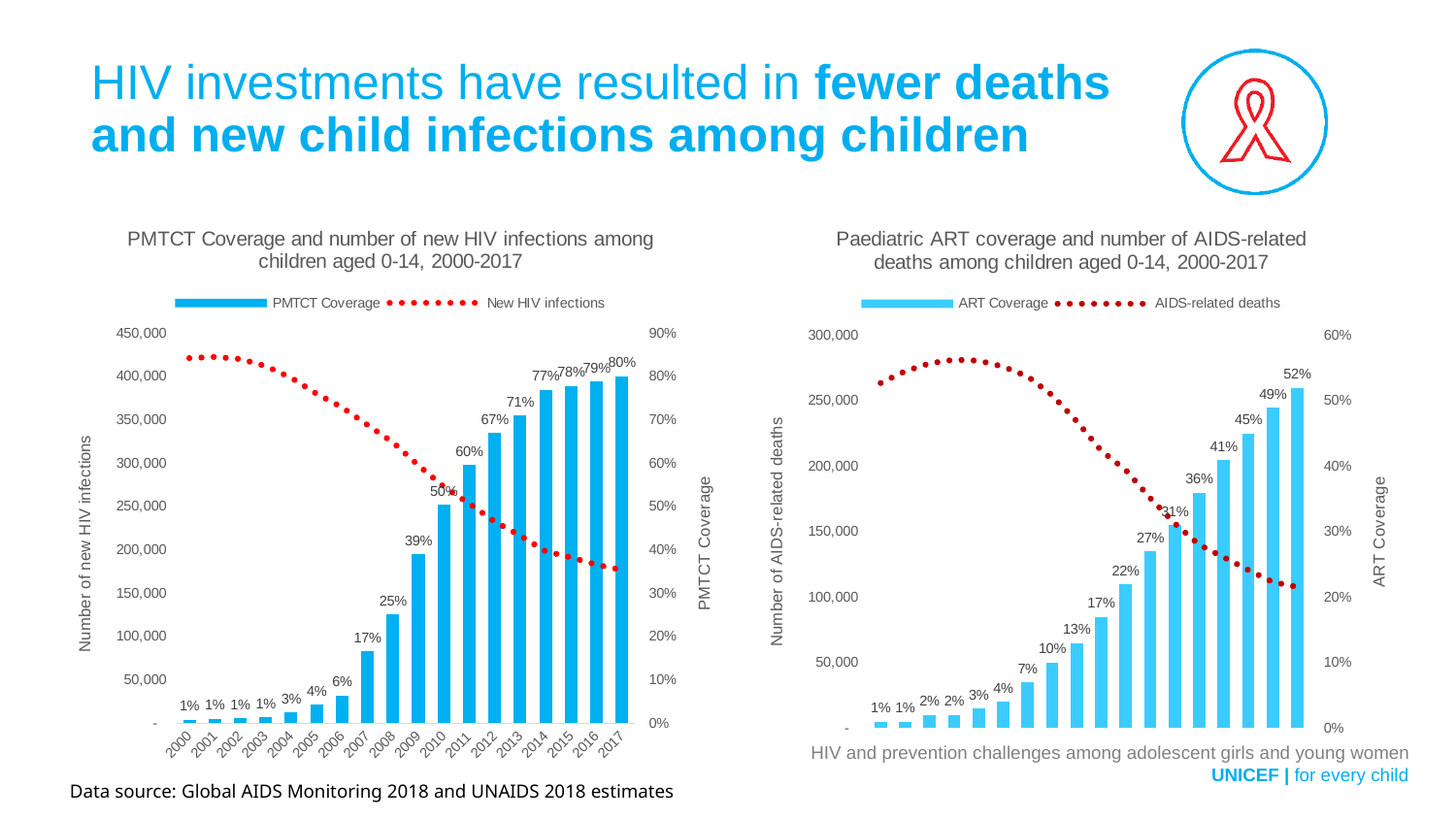
On the left chart (PMTCT Coverage and number of new HIV infections), what is the PMTCT coverage for 2017? 80% On the left chart (PMTCT Coverage and number of new HIV infections), what is the PMTCT coverage for 2010? 50% On the right chart (Paediatric ART coverage and number of AIDS-related deaths), how many bars are plotted for ART coverage? 18 On the left chart (PMTCT Coverage and number of new HIV infections), by how many percentage points did PMTCT coverage increase from 2009 to 2011? 21 percentage points On the left chart (PMTCT Coverage and number of new HIV infections), is the number of new HIV infections in 2000 greater or less than 400,000? greater On the left chart (PMTCT Coverage and number of new HIV infections), what is the PMTCT coverage for 2008? 25% On the right chart (Paediatric ART coverage and number of AIDS-related deaths), is the number of AIDS-related deaths at the end of the period greater or less than 150,000? less On the right chart (Paediatric ART coverage and number of AIDS-related deaths), what is the highest ART coverage value shown? 52% On the left chart (PMTCT Coverage and number of new HIV infections), how many series does the legend list? 2 On the left chart (PMTCT Coverage and number of new HIV infections), which year has the highest PMTCT coverage? 2017 On the right chart (Paediatric ART coverage and number of AIDS-related deaths), what colour are the ART Coverage bars? Light blue On the left chart (PMTCT Coverage and number of new HIV infections), does the number of new HIV infections rise or fall from 2000 to 2017? fall